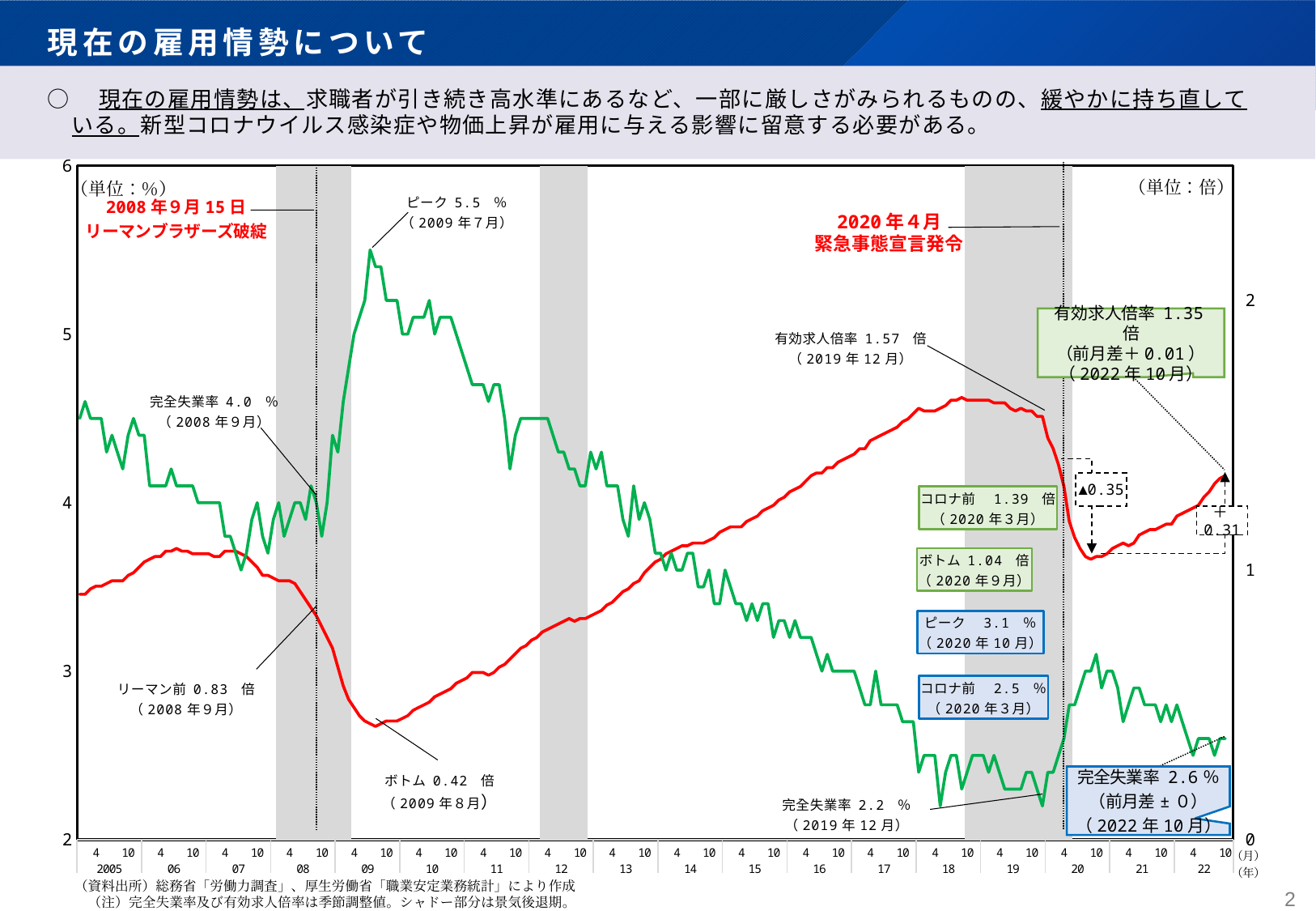
What is the difference between the unemployment rate peak of July 2009 (5.5%) and the December 2019 value (2.2%)? 3.3 percentage points What type of chart is shown on the slide? line chart What was the job openings-to-applicants ratio (有効求人倍率) in October 2022? 1.35倍 What was the pre-COVID (コロナ前) job openings-to-applicants ratio in March 2020? 1.39倍 Was the unemployment rate (green line) at the start of 2005 greater or less than 4%? greater What was the peak value of the unemployment rate (完全失業率) in July 2009 according to the annotation? 5.5% What unit is shown for the right-hand axis of the chart? 倍 What was the month-on-month change (前月差) in the job openings-to-applicants ratio in October 2022? +0.01 By how much did the job openings-to-applicants ratio fall from the pre-COVID level of 1.39倍 (March 2020) to the bottom of 1.04倍 (September 2020)? 0.35 What was the unemployment rate (完全失業率) in October 2022? 2.6% Which was higher: the unemployment rate peak in July 2009 or the unemployment rate peak in October 2020? July 2009 (5.5%) What was the job openings-to-applicants ratio (有効求人倍率) at its bottom in August 2009? 0.42倍